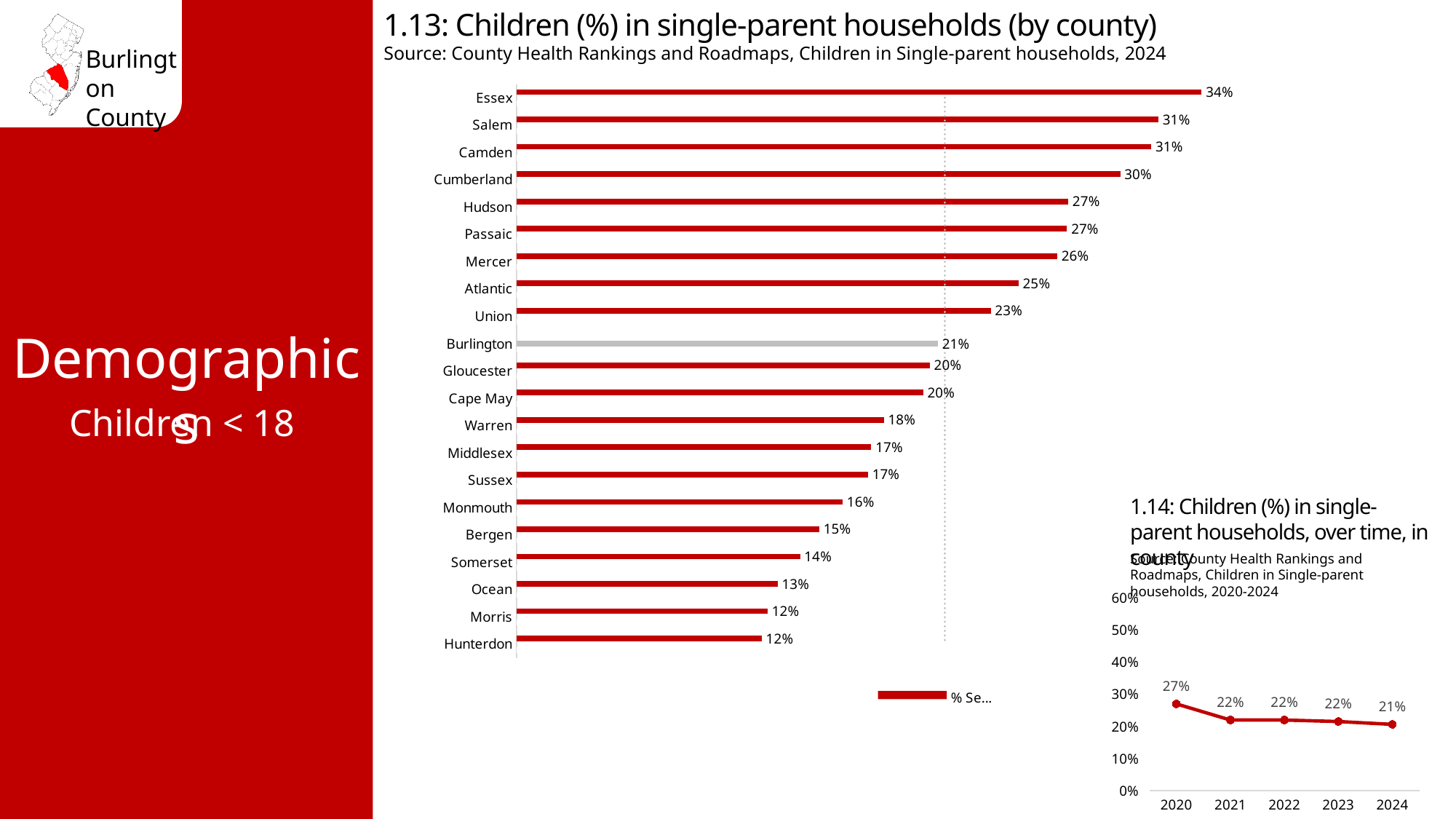
In chart 1.13 (Children in single-parent households by county), what is the value for Burlington? 21% What kind of chart is chart 1.14 (over time, in county)? Line chart In chart 1.13 (by county), how many counties are shown? 21 In chart 1.13 (by county), which county has the highest percentage of children in single-parent households? Essex In chart 1.14 (over time, in county), do the values rise or fall from 2020 to 2024? Fall In chart 1.14 (over time, in county), what is the value for 2024? 21% In chart 1.13 (by county), what is the value for Cumberland? 30% In chart 1.13 (by county), what is the value for Essex? 34% In chart 1.14 (over time, in county), what is the value for 2020? 27% In chart 1.13 (by county), which is larger, the value for Hudson or the value for Atlantic? Hudson What kind of chart is chart 1.13 (by county)? Bar chart In chart 1.13 (by county), what is the difference between Essex and Burlington? 13 percentage points